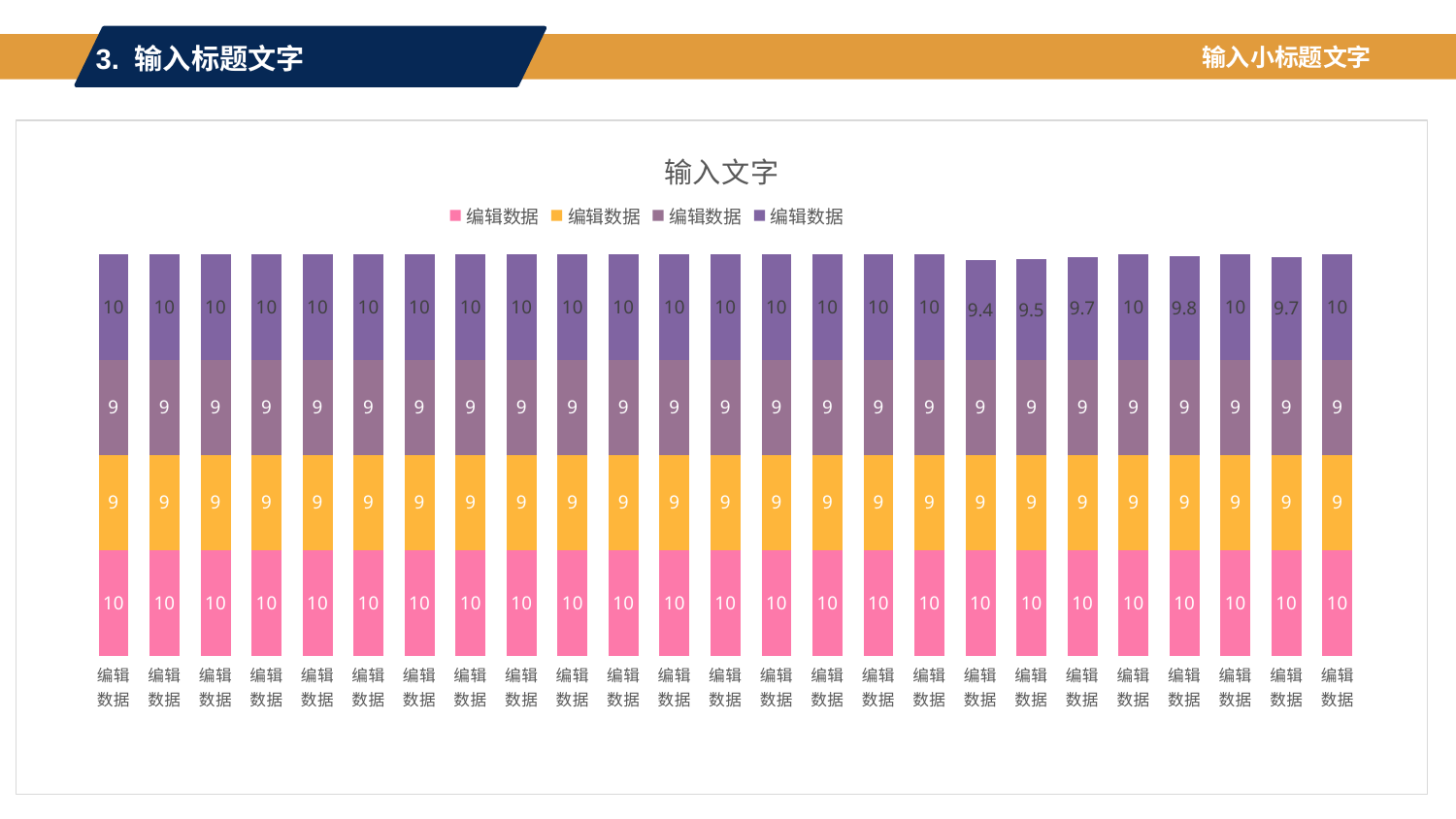
What is the difference between the top (purple) segment of the first bar and the top segment of the 18th bar from the left? 0.6 Which is larger: the top (purple) segment of the 19th bar from the left or that of the 20th bar from the left? the 20th bar (9.7) How many bars (categories) are plotted in the chart? 25 What is the value of the yellow segment of the last bar on the right? 9 Which bar has the lowest value for its top (purple) segment? the 18th bar from the left (9.4) What kind of chart is shown on the slide? stacked bar chart What is the value of the bottom (pink) segment of the first bar from the left? 10 What is the total of the stacked segments in the 18th bar from the left? 37.4 What is the title of the chart? 输入文字 What is the value of the top (purple) segment of the 18th bar from the left? 9.4 What is the total of the stacked segments in the first bar from the left? 38 How many series does the legend list? 4